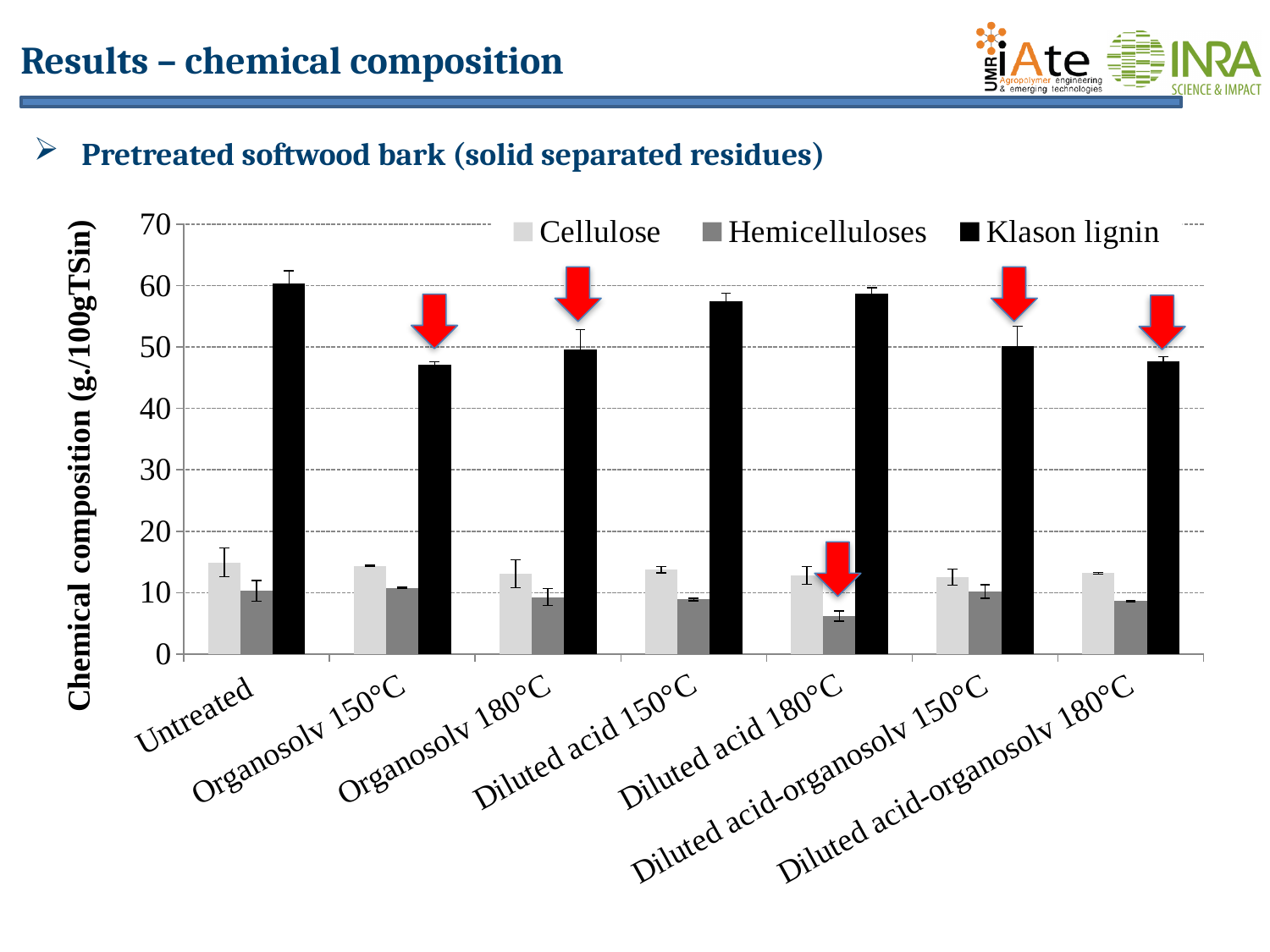
Which category has the lowest Hemicelluloses value? Diluted acid 180°C Is the Klason lignin value for Diluted acid 180°C greater or less than 50? greater Is the Hemicelluloses value for Diluted acid 180°C greater or less than 10? less For Untreated, which is larger, the Cellulose value or the Hemicelluloses value? Cellulose What is the title of the y axis? Chemical composition (g./100gTSin) How many series does the legend list? 3 What kind of chart is shown on the slide? bar chart How many pretreatment categories are shown on the x axis? 7 Is the Klason lignin value for Organosolv 150°C greater or less than 50? less Which is larger, the Klason lignin value for Untreated or for Organosolv 150°C? Untreated